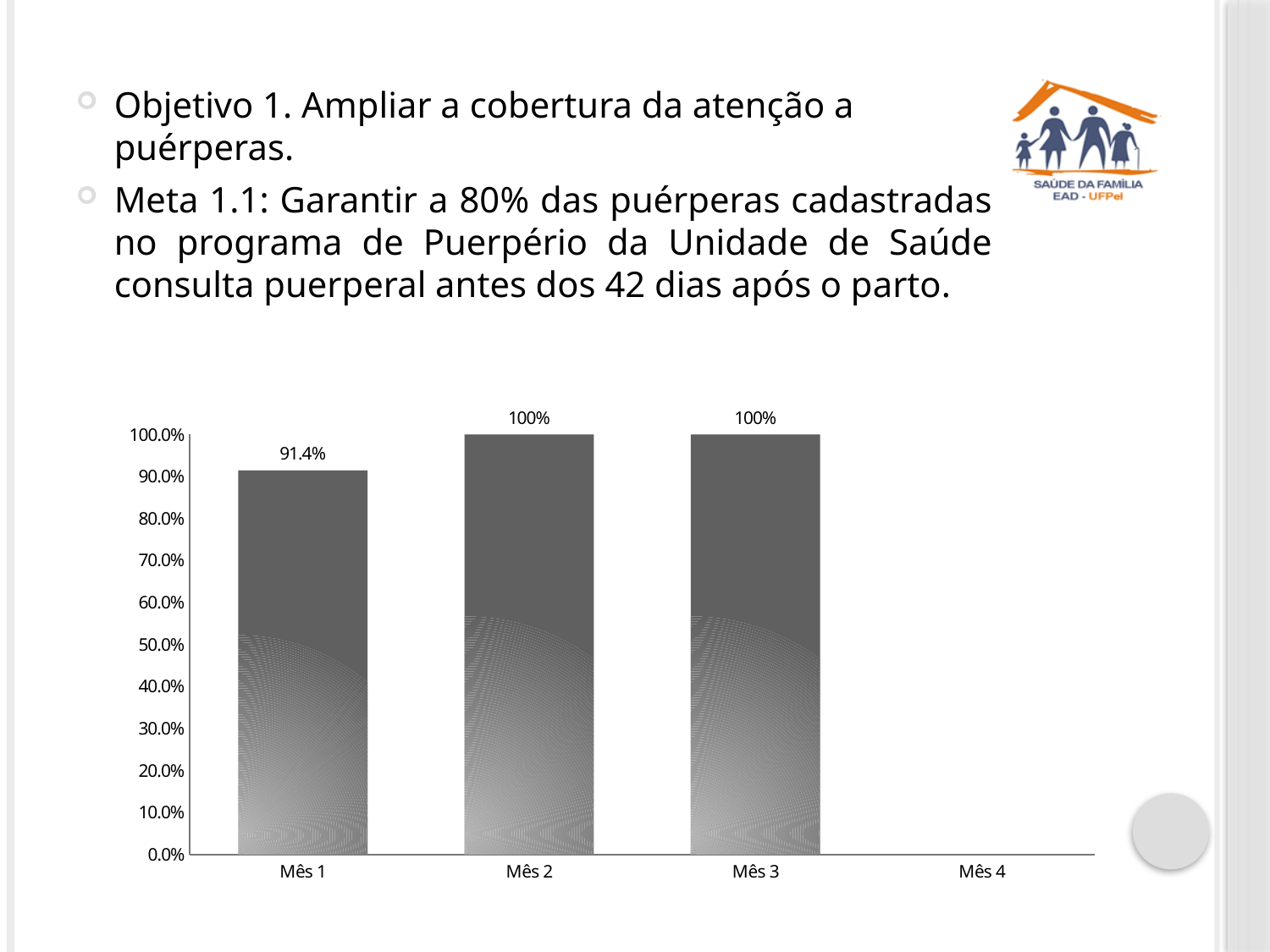
What is the value for Mês 2? 100% Which is larger, the value for Mês 1 or the value for Mês 2? Mês 2 Which month on the x axis has no bar plotted? Mês 4 What is the difference between the values for Mês 2 and Mês 1? 8.6 percentage points What is the highest value shown on the chart? 100% How many month categories are labelled on the x axis? 4 What kind of chart is shown on the slide? bar chart Does the value rise or fall from Mês 1 to Mês 2? rise Is the value for Mês 1 greater or less than 80.0%? greater What is the value for Mês 1? 91.4% What is the value for Mês 3? 100% Which month has the lowest plotted value? Mês 1